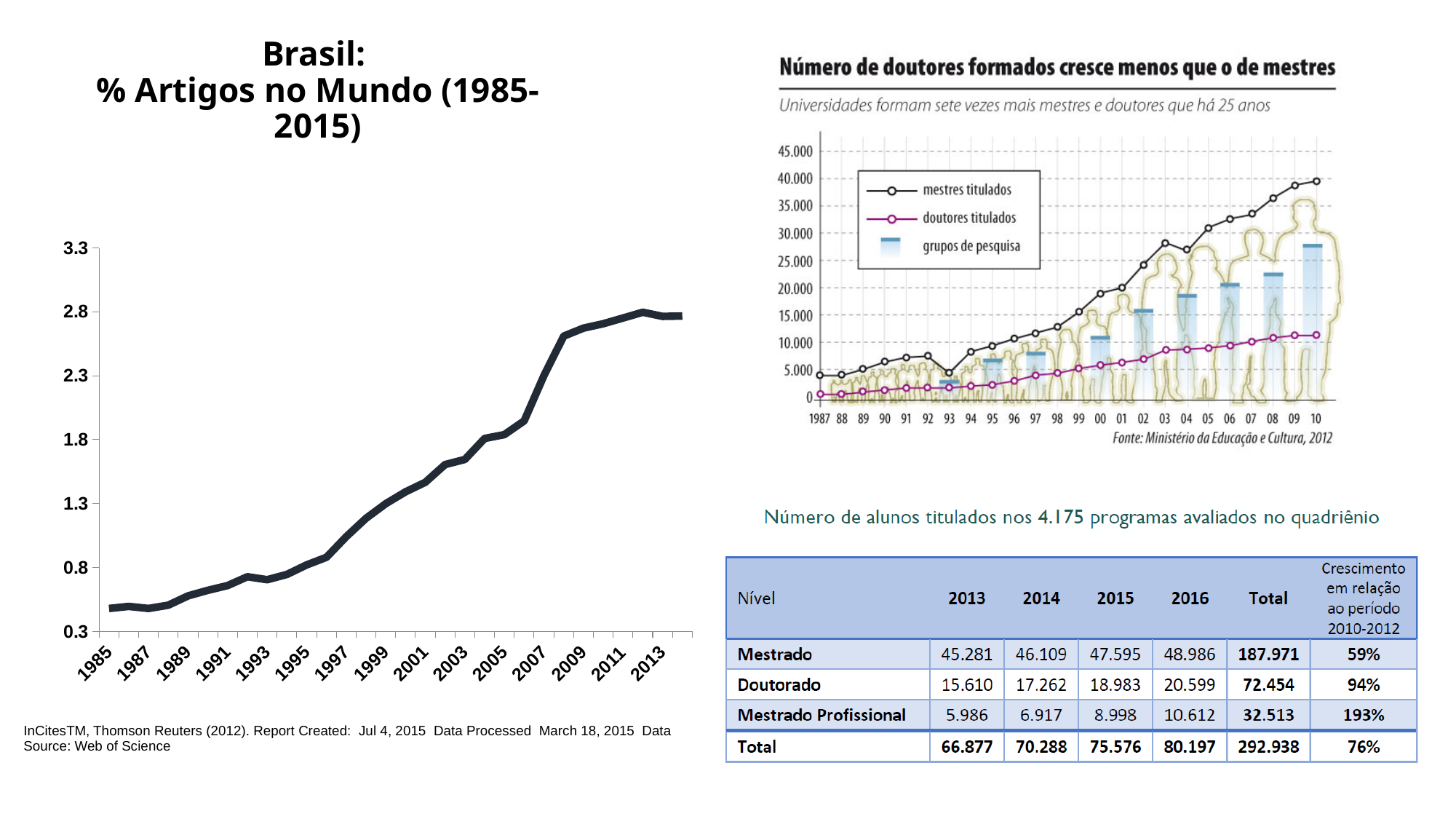
In the left chart 'Brasil: % Artigos no Mundo', do the values generally rise or fall from 1985 to 2015? rise In the left chart 'Brasil: % Artigos no Mundo', which year has the larger value, 1985 or 2009? 2009 What kind of chart is the left chart titled 'Brasil: % Artigos no Mundo (1985-2015)'? line chart How many series does the legend of the right chart 'Número de doutores formados cresce menos que o de mestres' list? 3 What source is cited below the right chart 'Número de doutores formados cresce menos que o de mestres'? Ministério da Educação e Cultura, 2012 In the right chart 'Número de doutores formados cresce menos que o de mestres', in which year does the mestres titulados series reach its highest value? 2010 In the left chart 'Brasil: % Artigos no Mundo', is the value for 2001 greater or less than 1.3? greater In the right chart 'Número de doutores formados cresce menos que o de mestres', is the value of mestres titulados in 2010 greater or less than 35.000? greater In the right chart 'Número de doutores formados cresce menos que o de mestres', is the value of doutores titulados in 2010 greater or less than 15.000? less In the right chart 'Número de doutores formados cresce menos que o de mestres', which series has the larger value in 2010, mestres titulados or doutores titulados? mestres titulados